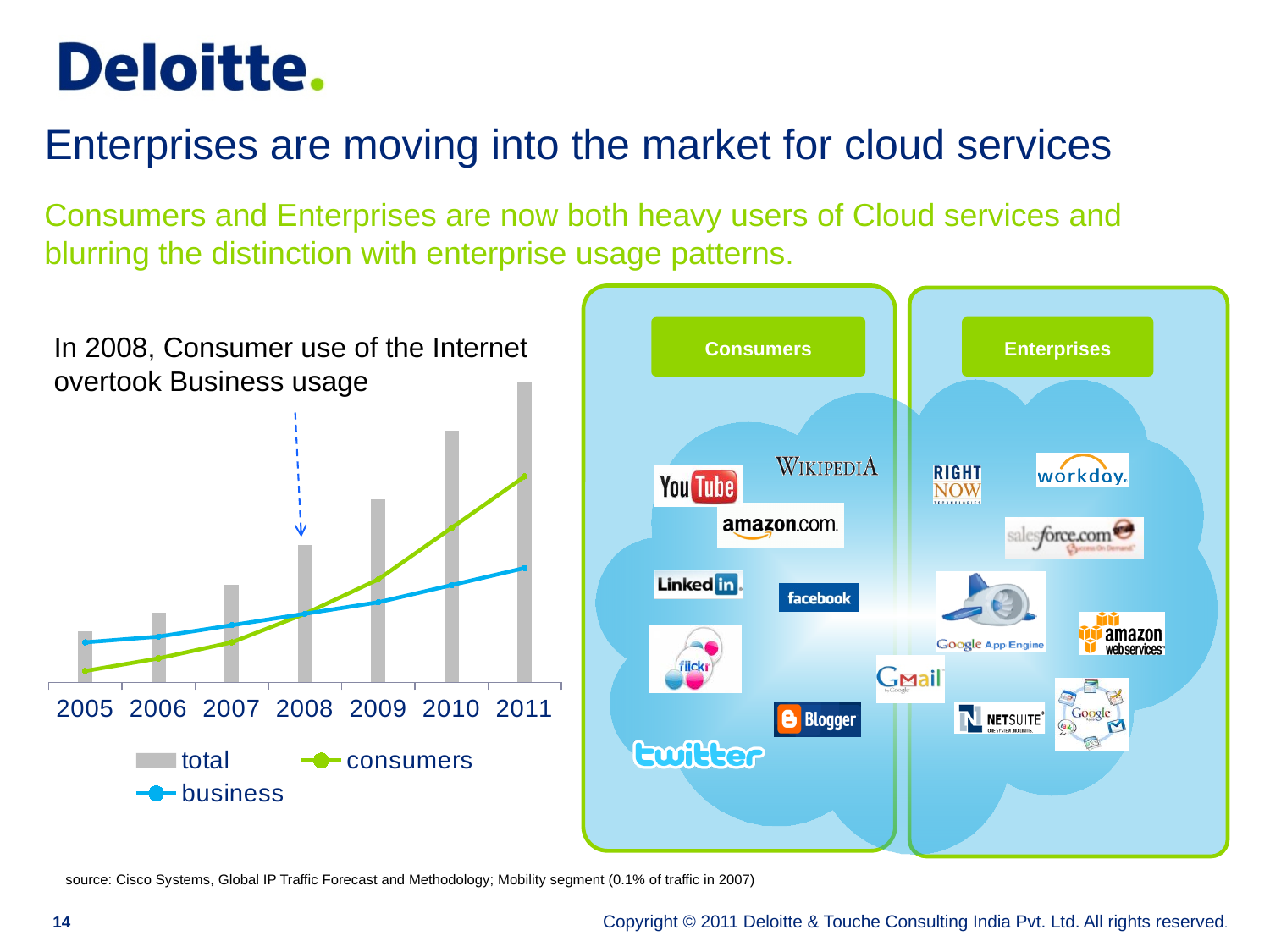
What is the first year shown on the chart's x axis? 2005 Do the 'total' bars rise or fall from 2005 to 2011? Rise How many years are shown on the x axis of the chart? 7 Which year has the shortest 'total' bar? 2005 What are the three series named in the chart's legend? total, consumers, business In 2005, which series is higher: consumers or business? business In 2011, which series is higher: consumers or business? consumers What kind of chart is shown on the slide? A combined bar and line chart Which year has the tallest 'total' bar? 2011 Does the 'consumers' line rise or fall across the years shown? Rise How many series does the chart's legend list? 3 What colour is the 'business' line in the chart? Blue